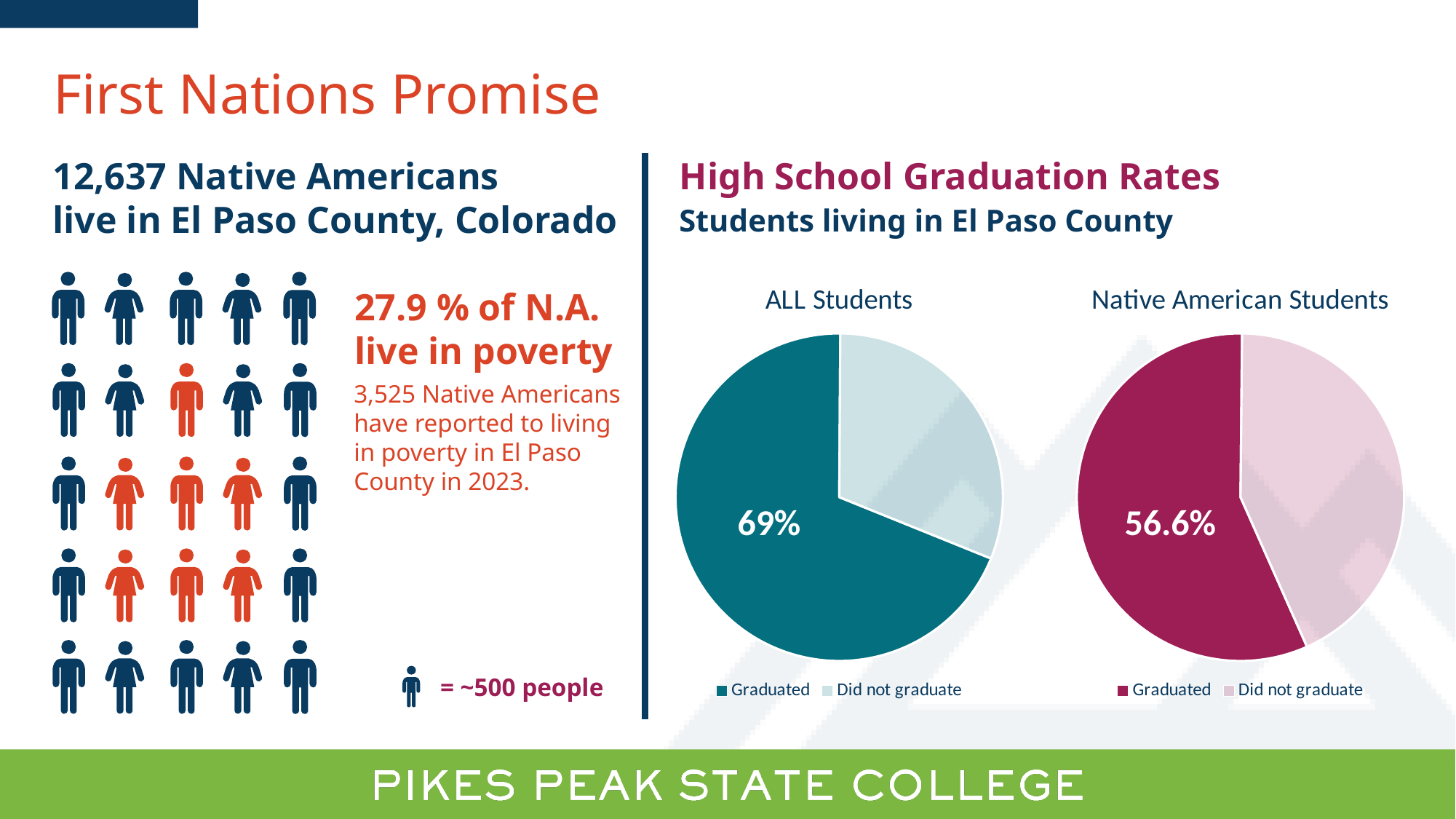
What kind of chart is used to show the High School Graduation Rates? Pie chart How many entries does the legend of the 'ALL Students' pie chart list? 2 In the 'Native American Students' pie chart, which slice is the largest? Graduated What is the title above the two pie charts? High School Graduation Rates Which pie chart shows the larger 'Graduated' share, 'ALL Students' or 'Native American Students'? ALL Students In the 'ALL Students' pie chart, what percentage of students graduated? 69% What is the difference in percentage points between the graduation rate for ALL Students and for Native American Students? 12.4 What are the two legend entries of the 'Native American Students' pie chart? Graduated, Did not graduate How many pie charts are shown under 'High School Graduation Rates'? 2 In the 'Native American Students' pie chart, what percentage of students graduated? 56.6% In the 'ALL Students' pie chart, what share of the pie is 'Did not graduate'? 31%